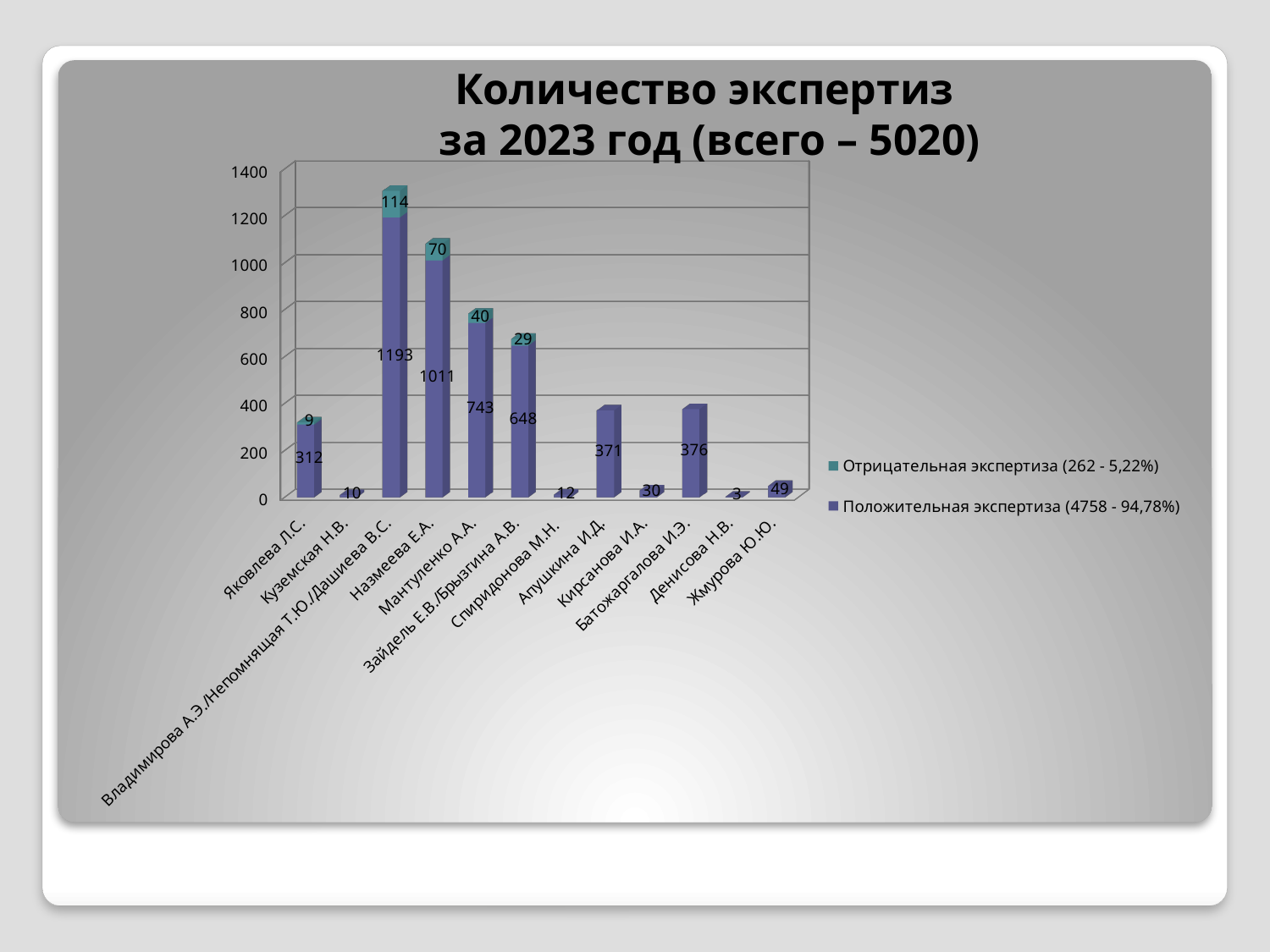
What is the value of Отрицательная экспертиза for Владимирова А.Э./Непомнящая Т.Ю./Дашиева В.С.? 114 What is the difference between the Положительная экспертиза values for Мантуленко А.А. and Зайдель Е.В./Брызгина А.В.? 95 Which is larger, the Положительная экспертиза value for Апушкина И.Д. or for Яковлева Л.С.? Апушкина И.Д. What is the value of Положительная экспертиза for Батожаргалова И.Э.? 376 What total number of expert examinations for 2023 is stated in the chart title? 5020 How many series does the legend list? 2 What is the value of Положительная экспертиза for Назмеева Е.А.? 1011 What kind of chart is shown on the slide? Stacked bar chart What is the total of the stacked bar for Назмеева Е.А.? 1081 Which category has the lowest value of Положительная экспертиза? Денисова Н.В. How many categories (experts) are shown on the x axis? 12 Which category has the highest value of Положительная экспертиза? Владимирова А.Э./Непомнящая Т.Ю./Дашиева В.С.